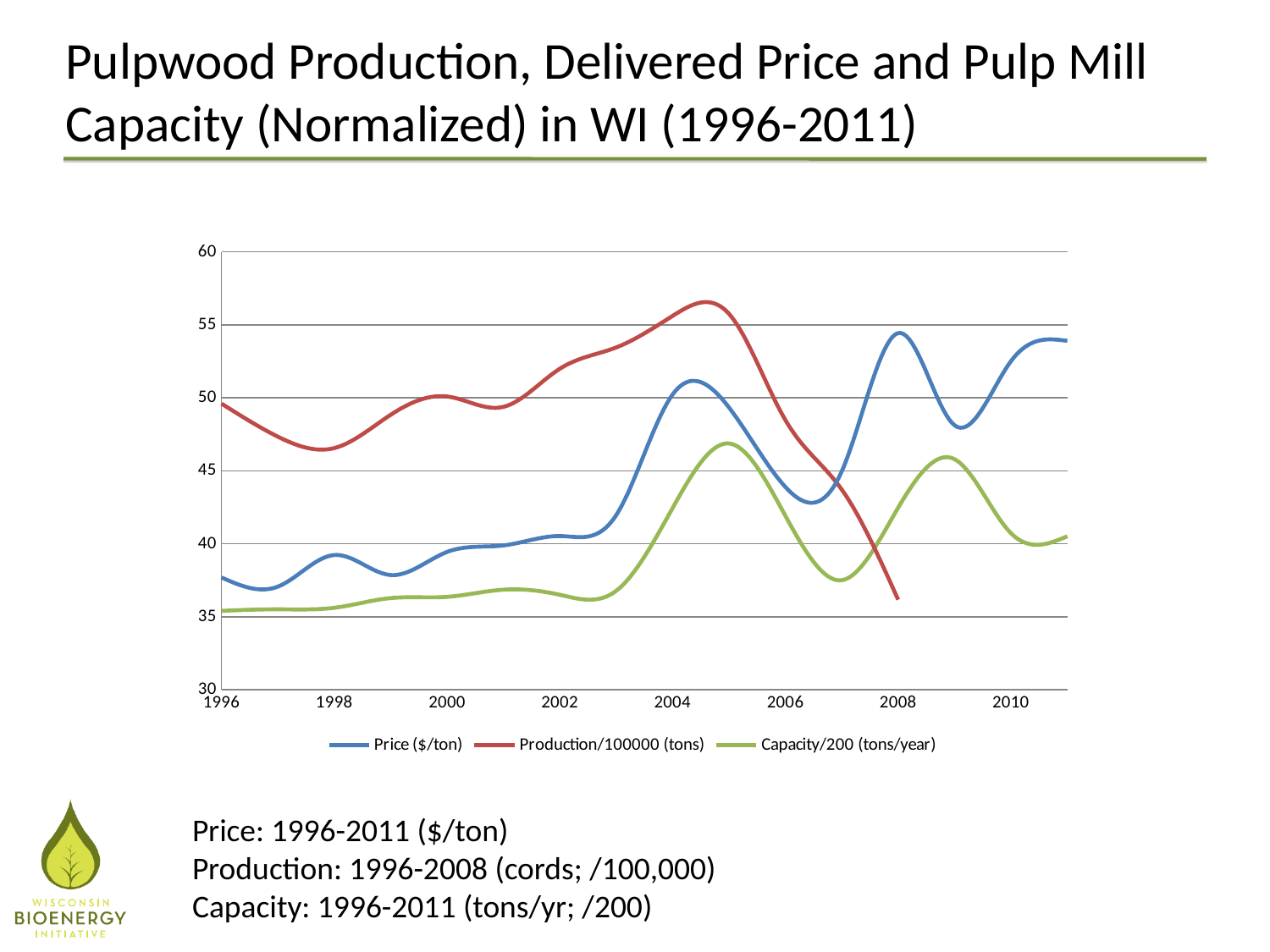
In 2008, which is larger: Price ($/ton) or Production/100000 (tons)? Price ($/ton) Is the value for Capacity/200 (tons/year) in 2005 greater or less than 45? greater Is the value for Price ($/ton) in 1996 greater or less than 40? less Is the value for Price ($/ton) in 2008 greater or less than 50? greater Does the Production/100000 (tons) line rise or fall from 2005 to 2008? fall Which series has the lowest value in 1996? Capacity/200 (tons/year) In 1996, which is larger: Production/100000 (tons) or Price ($/ton)? Production/100000 (tons) Which series is drawn in red? Production/100000 (tons) What kind of chart is shown on the slide? line chart How many series does the legend list? 3